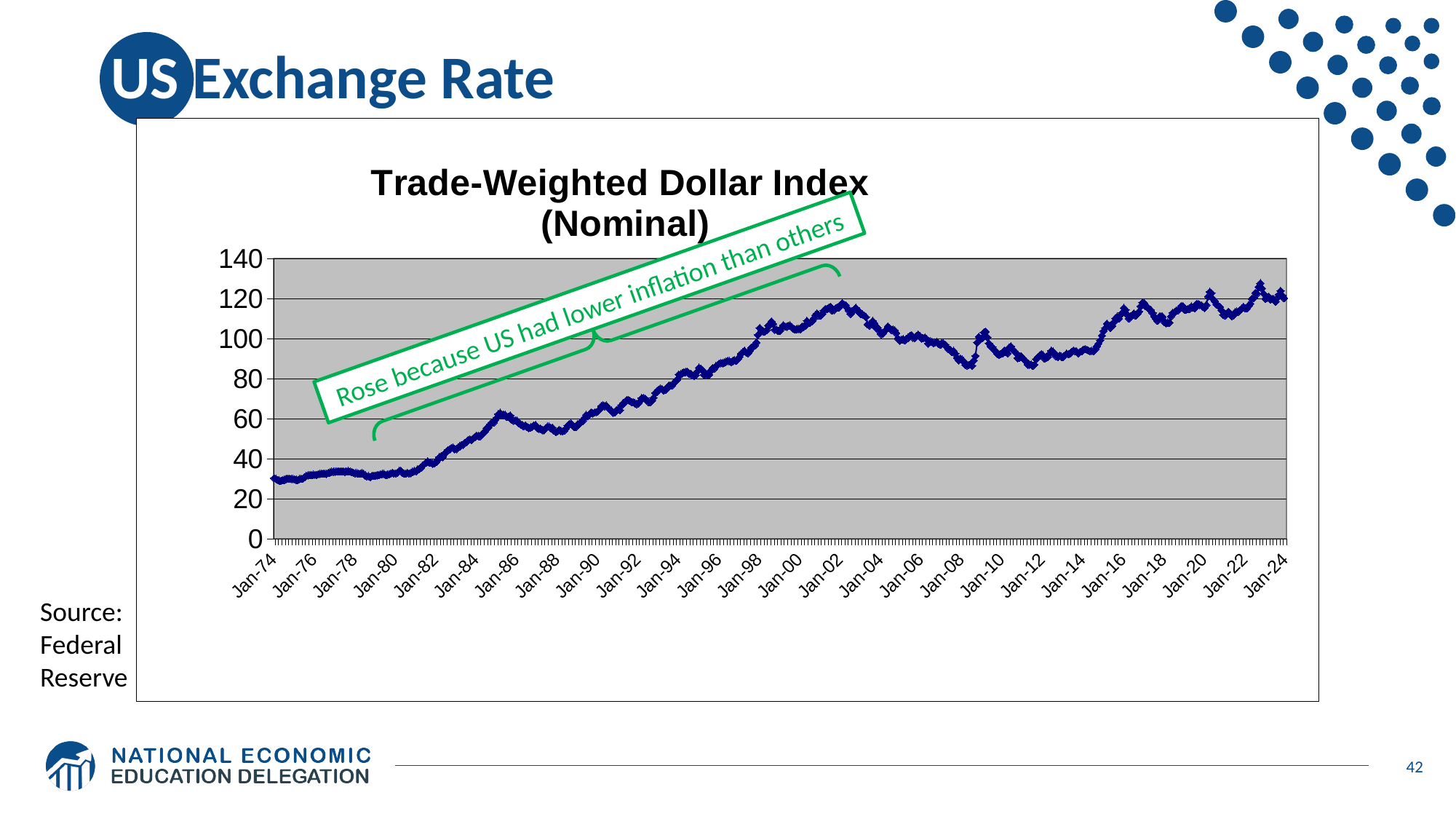
Which is larger, the Trade-Weighted Dollar Index at Jan-74 or at Jan-02? Jan-02 Is the value of the Trade-Weighted Dollar Index at Jan-24 greater or less than 100? greater What is the title of the chart? Trade-Weighted Dollar Index (Nominal) Is the value of the Trade-Weighted Dollar Index at Jan-02 greater or less than 100? greater What is the highest value shown on the vertical axis of the chart? 140 Is the value of the Trade-Weighted Dollar Index at Jan-74 greater or less than 40? less Does the Trade-Weighted Dollar Index generally rise or fall between Jan-80 and Jan-02? Rise Which is larger, the Trade-Weighted Dollar Index at Jan-02 or at Jan-12? Jan-02 Does the Trade-Weighted Dollar Index generally rise or fall between Jan-02 and Jan-08? Fall What kind of chart is shown on the slide? Line chart